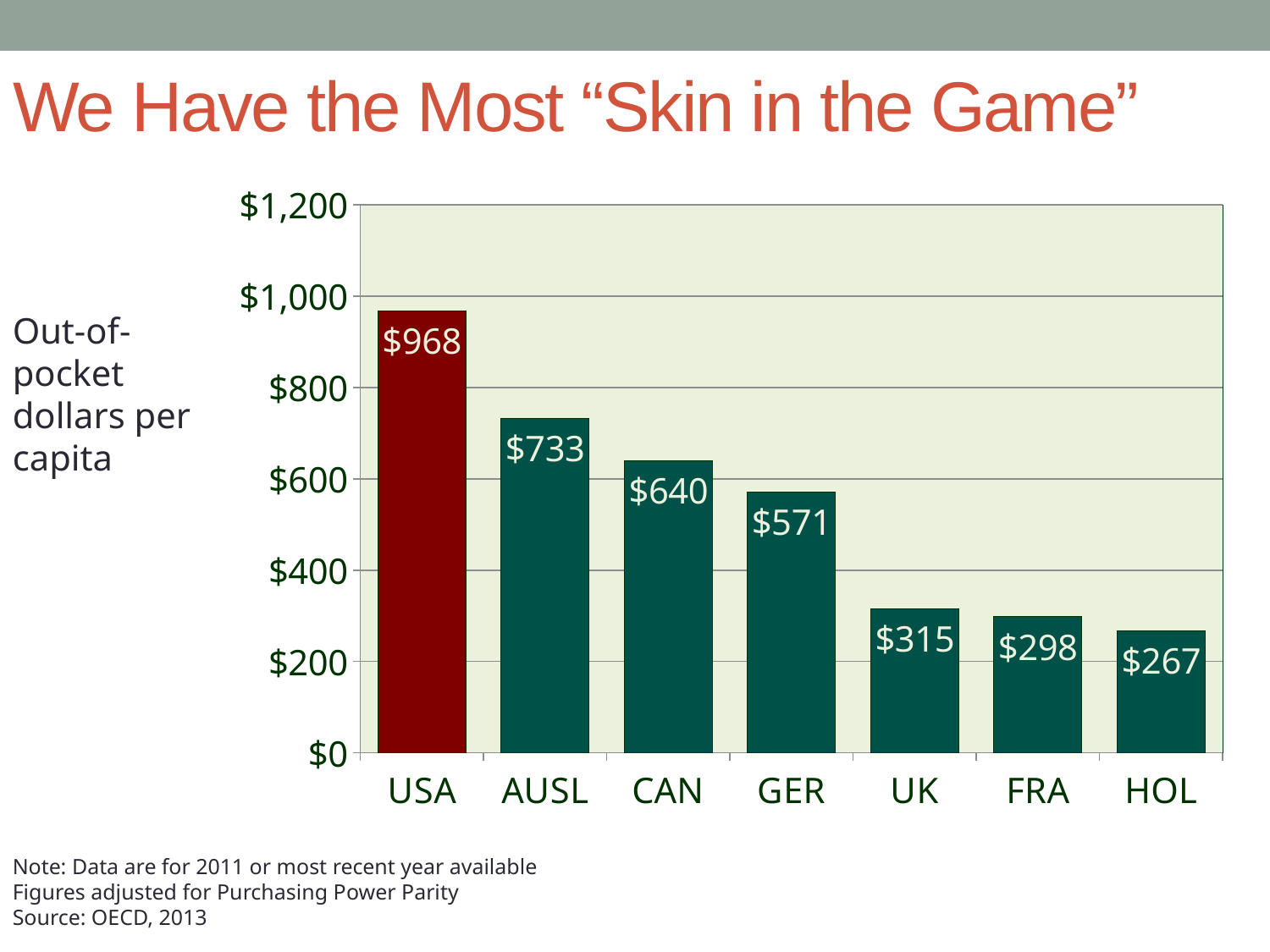
What is the difference between the values for UK and FRA? $17 How many countries are shown on the chart? 7 Which country has the lowest out-of-pocket dollars per capita? HOL What kind of chart is shown on the slide? bar chart What is the value shown for GER? $571 What is the value shown for HOL? $267 What is the difference between the values for USA and AUSL? $235 Which has a larger value, CAN or GER? CAN Which bar is coloured differently (dark red) from the others? USA Is the value for AUSL greater or less than $800? less Which country has the highest out-of-pocket dollars per capita? USA What is the out-of-pocket dollars per capita value for USA? $968